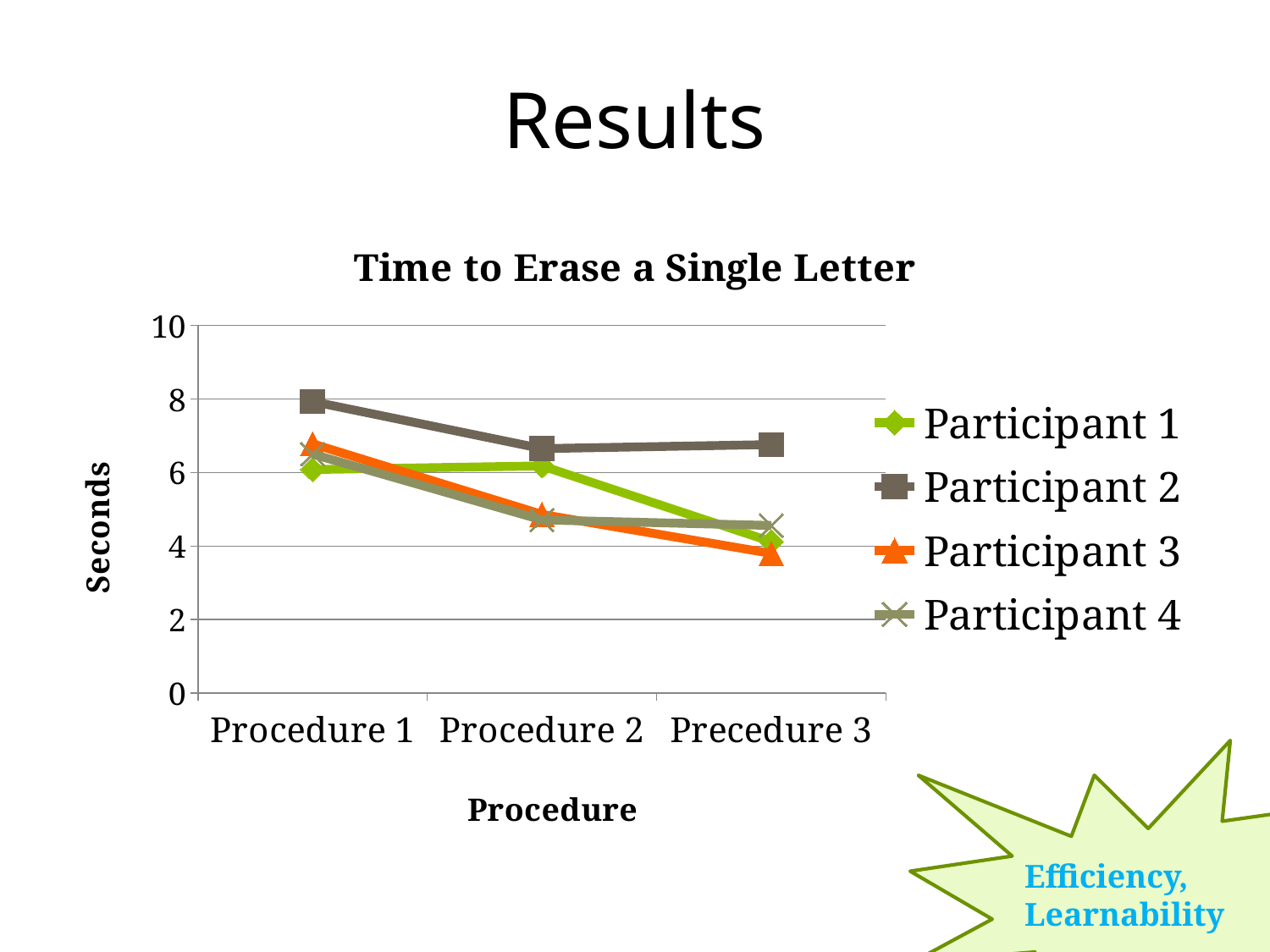
Is the value for Participant 2 at Procedure 1 greater or less than 6? greater Which participant has the highest time at Procedure 1? Participant 2 How many series does the legend list? 4 At Procedure 3, which is larger: the value for Participant 2 or Participant 4? Participant 2 Is the value for Participant 4 at Procedure 2 greater or less than 6? less What kind of chart is shown on the slide? line chart Is the value for Participant 2 at Procedure 3 greater or less than 6? greater How many procedures are shown on the x axis? 3 Does the time for Participant 3 rise or fall from Procedure 1 to Procedure 3? fall What is the title of the chart? Time to Erase a Single Letter At Procedure 2, which is larger: the value for Participant 1 or Participant 3? Participant 1 Which participant has the highest time at Procedure 3? Participant 2